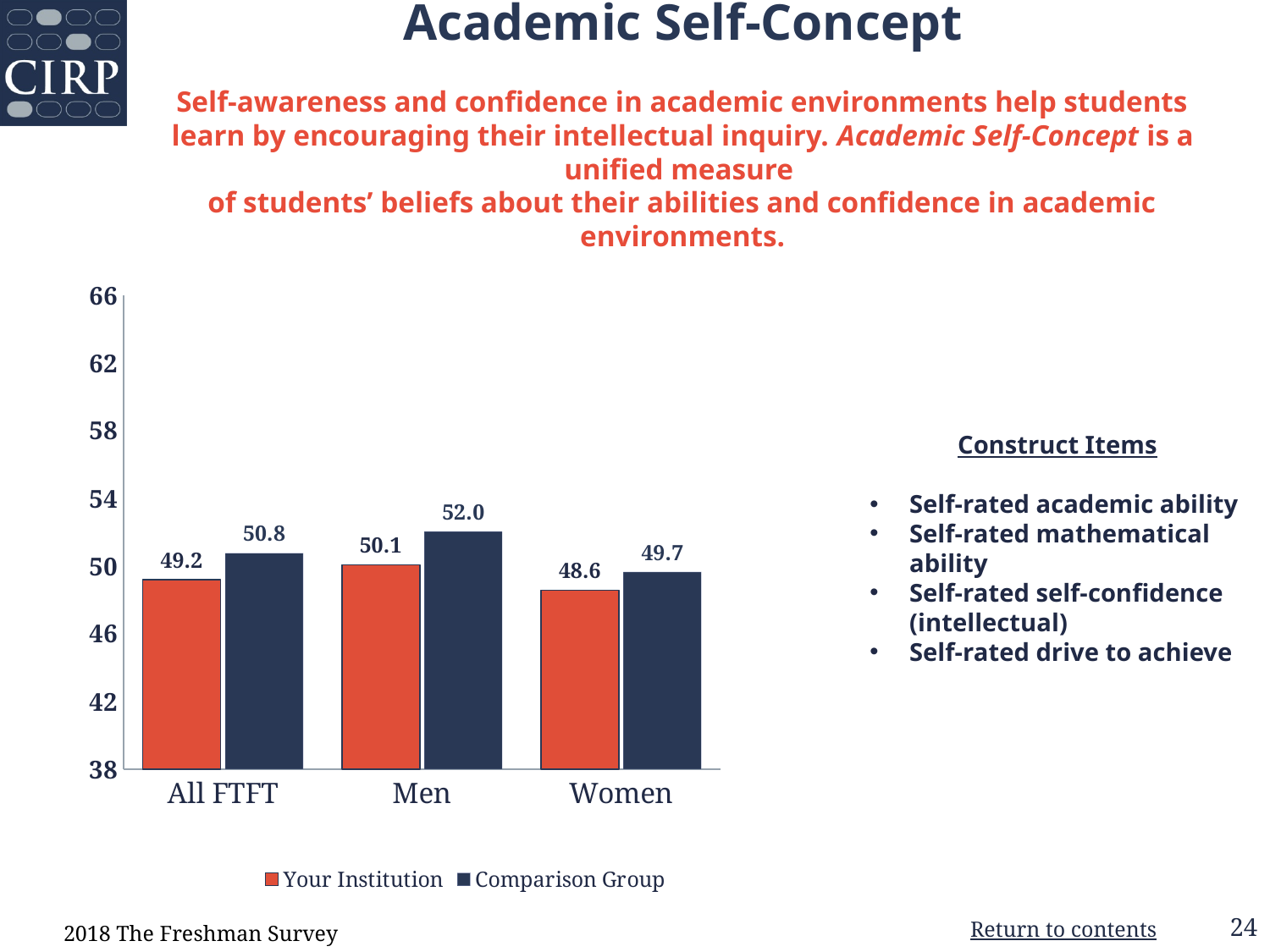
What is the difference between the Comparison Group and Your Institution values for All FTFT? 1.6 Which is larger for Women: Your Institution or Comparison Group? Comparison Group Which category has the lowest Your Institution value? Women Which category has the highest Comparison Group value? Men What kind of chart is shown on the slide? bar chart What is the value for Your Institution in the Men category? 50.1 How many series does the legend list? 2 Is the Your Institution value for Women greater or less than 50? less What is the value for Comparison Group in the Women category? 49.7 What is the difference between the Comparison Group and Your Institution values for Men? 1.9 How many categories are shown on the x axis? 3 What is the value for Your Institution in the All FTFT category? 49.2